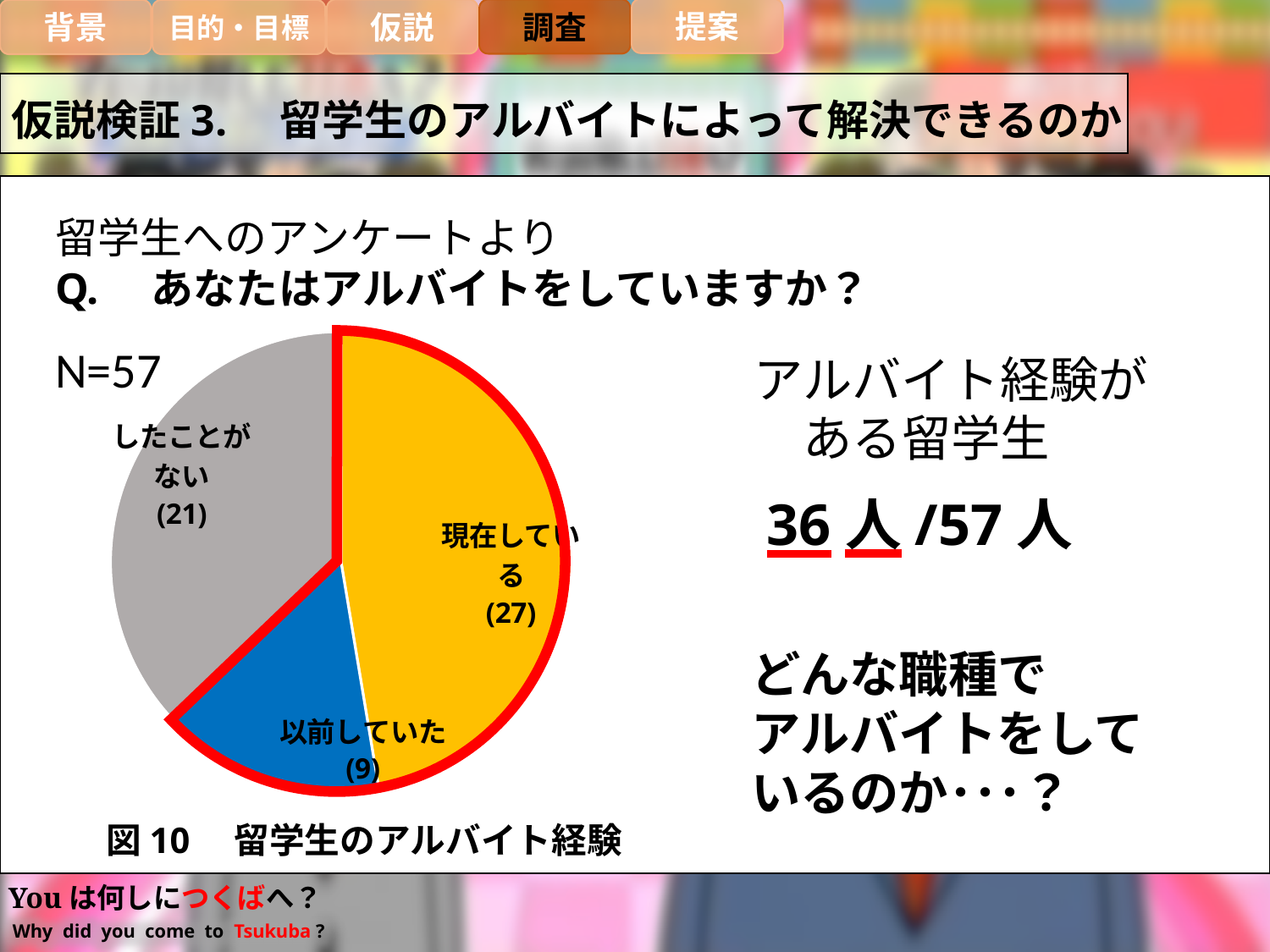
What is the caption of the pie chart? 図10 留学生のアルバイト経験 What is the difference between the number of したことがない and 以前していた respondents? 12 Which category has the largest slice in the pie chart? 現在している How many categories does the pie chart have? 3 What is the difference between the number of 現在している and したことがない respondents? 6 Which is larger, the 現在している slice or the 以前していた slice? 現在している What is the total number of respondents (N) for the pie chart? 57 How many people answered 現在している in the pie chart? 27 What kind of chart is shown on the slide? pie chart How many people answered したことがない in the pie chart? 21 How many people answered 以前していた in the pie chart? 9 Which category has the smallest slice in the pie chart? 以前していた